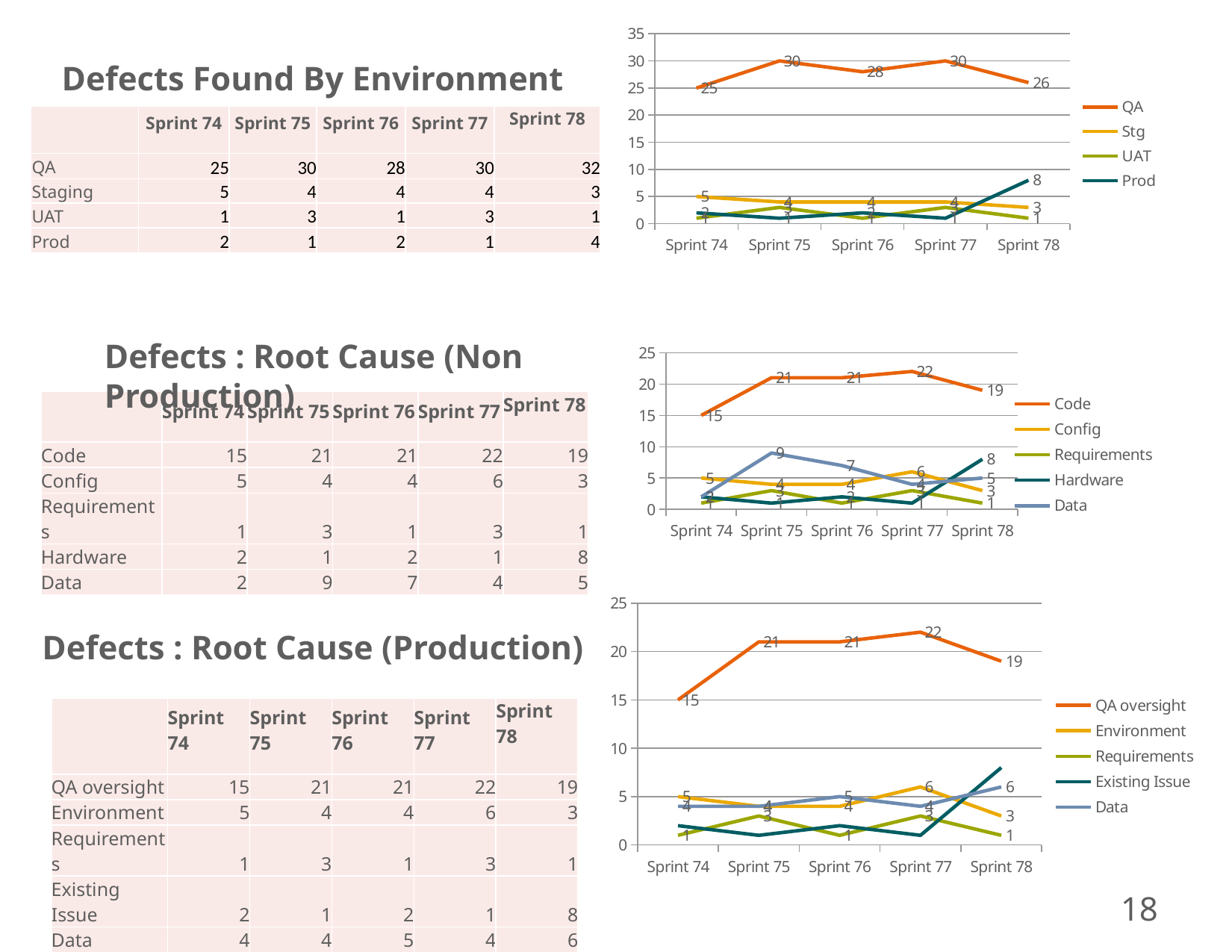
How many series does the legend of the middle-right chart list? 5 In the bottom-right line chart, what is the Data value at Sprint 78? 6 In the middle-right line chart, what is the Data value at Sprint 75? 9 In the top-right line chart, what is the Prod value at Sprint 78? 8 How many series does the legend of the top-right chart list? 4 In the middle-right line chart, at which sprint is the Code series highest? Sprint 77 In the top-right line chart, at which sprint is the QA series lowest? Sprint 74 In the top-right line chart, what is the difference between the QA values at Sprint 75 and Sprint 78? 4 What kind of chart is the top-right chart? Line chart In the middle-right line chart, is the Code value at Sprint 74 greater or less than 20? less In the bottom-right line chart, which is larger at Sprint 78: Existing Issue or Environment? Existing Issue In the top-right line chart, what is the QA value at Sprint 75? 30